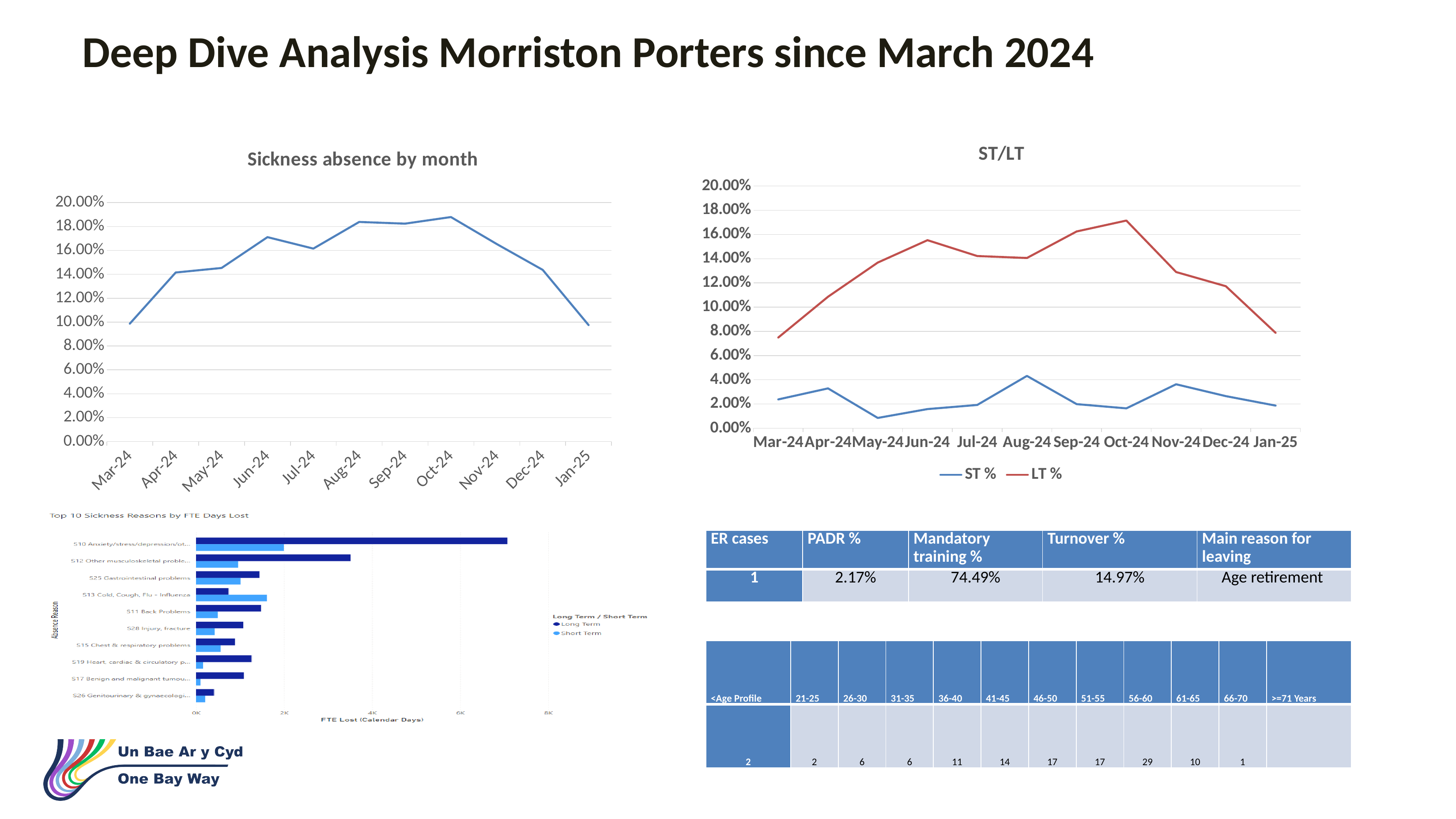
What kind of chart is "Top 10 Sickness Reasons by FTE Days Lost"? bar chart In the "Sickness absence by month" chart, is the value for Mar-24 greater or less than 12.00%? less In the "ST/LT" chart, which month has the lowest ST % value? May-24 In the "Top 10 Sickness Reasons by FTE Days Lost" chart, which absence reason has the longest Long Term bar? S10 Anxiety/stress/depression In the "ST/LT" chart, how many series does the legend list? 2 What kind of chart is "Sickness absence by month"? line chart In the "ST/LT" chart, which month has the highest ST % value? Aug-24 In the "Sickness absence by month" chart, is the value for Oct-24 greater or less than 16.00%? greater In the "Sickness absence by month" chart, do the values rise or fall from Oct-24 to Jan-25? fall In the "Sickness absence by month" chart, how many months are plotted? 11 In the "ST/LT" chart, which month has the highest LT % value? Oct-24 In the "ST/LT" chart, is the LT % value for Jun-24 greater or less than 14.00%? greater